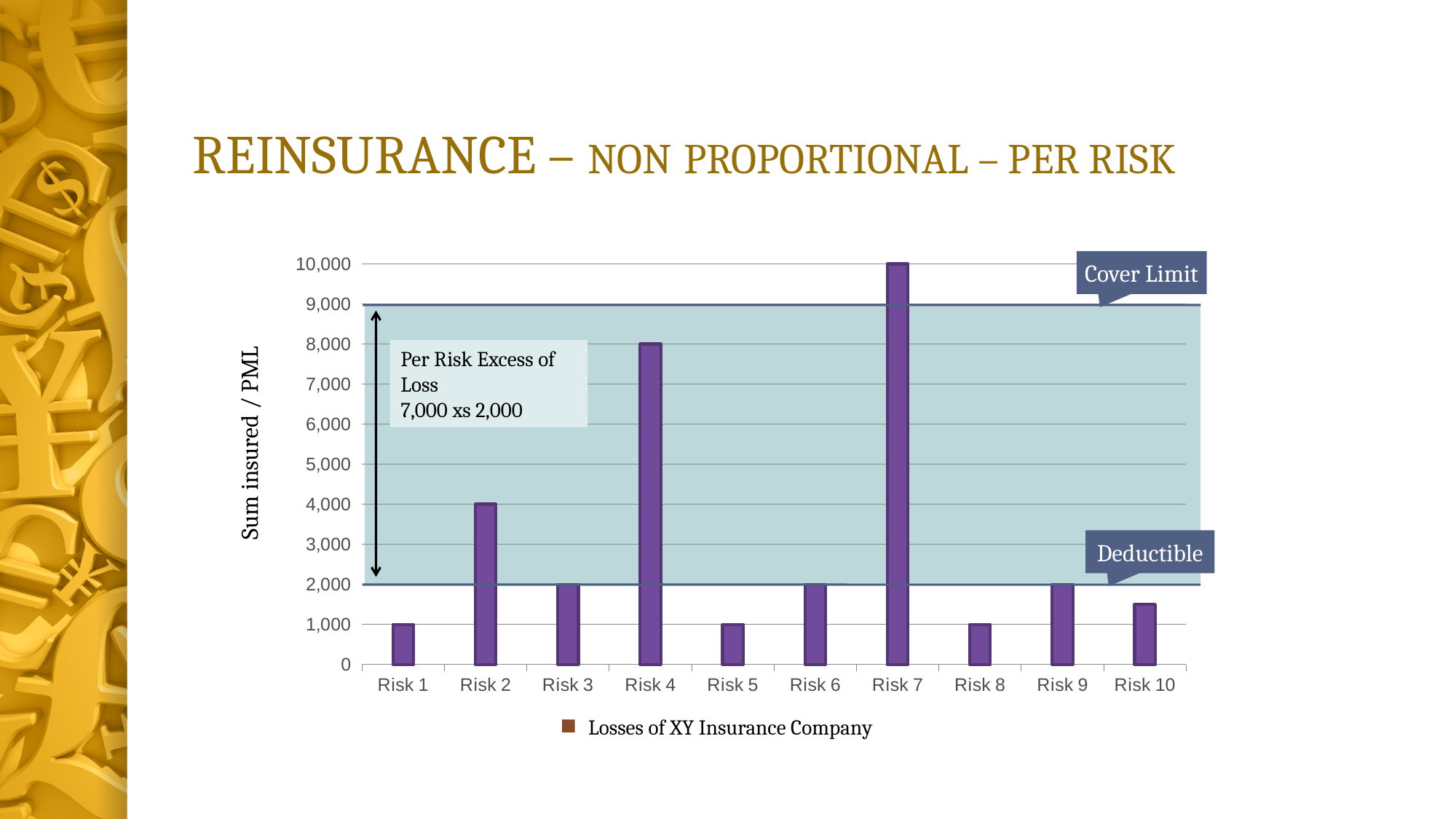
Is the value for Risk 10 greater or less than 1,000? greater Which is larger, the value for Risk 2 or the value for Risk 3? Risk 2 How many risk categories are plotted on the x axis? 10 What kind of chart is shown on the slide? bar chart What is the value for Risk 2? 4,000 What is the value for Risk 7? 10,000 What is the legend entry for the plotted series? Losses of XY Insurance Company Is the value for Risk 10 greater or less than 2,000? less What is the difference between the values for Risk 7 and Risk 4? 2,000 Which risk has the highest value? Risk 7 How many series does the legend list? 1 What is the value for Risk 4? 8,000